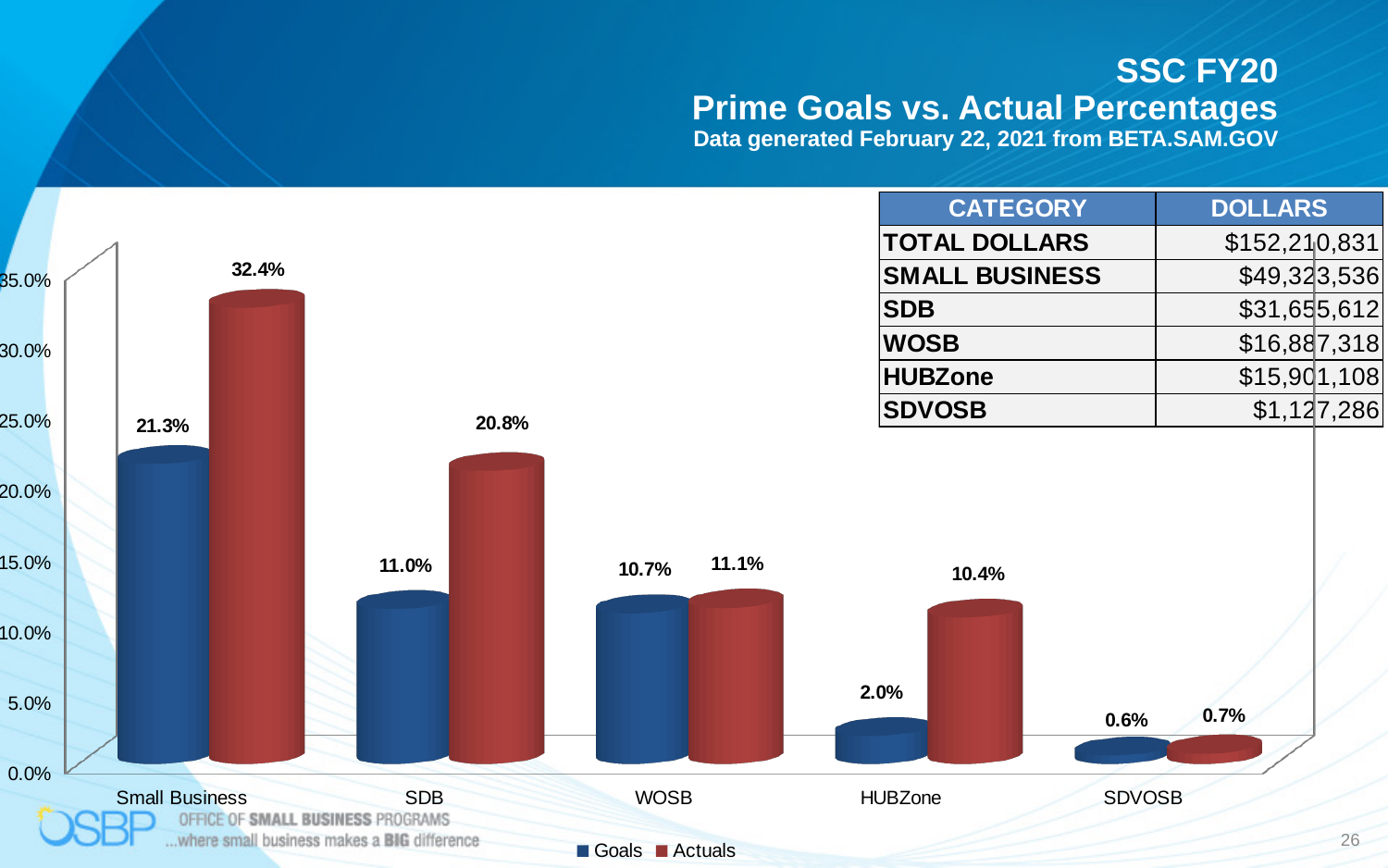
What is the Actuals value for HUBZone? 10.4% Which category has the lowest Goals value? SDVOSB Which category has the highest Actuals value? Small Business What is the Actuals value for SDB? 20.8% How many series does the chart legend list? 2 What is the Goals value for Small Business? 21.3% What is the Goals value for SDVOSB? 0.6% How many categories are shown on the x axis of the chart? 5 Which is larger for SDB, the Goals value or the Actuals value? Actuals What is the difference between the Actuals and Goals values for Small Business? 11.1% What is the difference between the Actuals and Goals values for HUBZone? 8.4% What kind of chart is shown on the slide? Bar chart